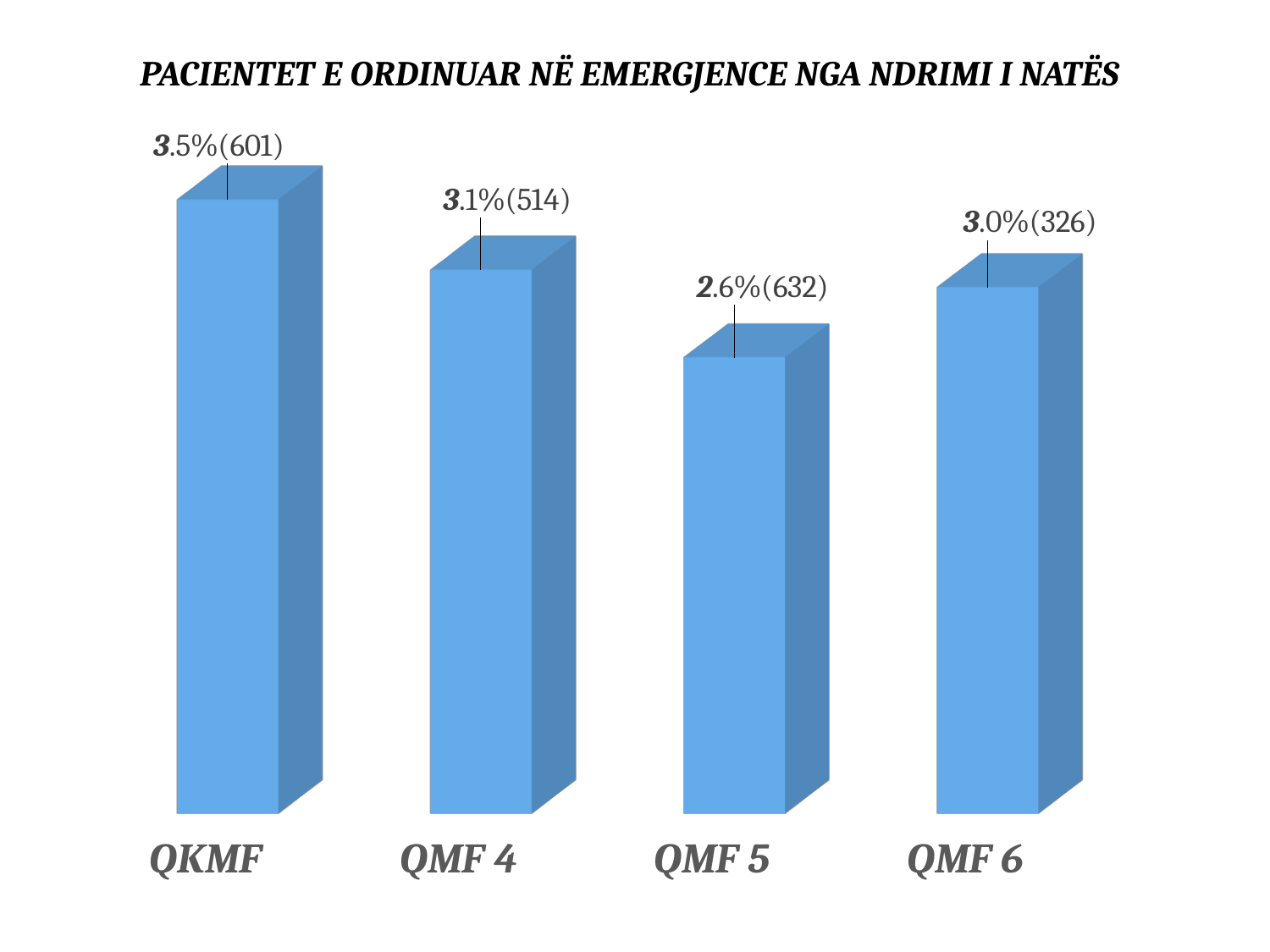
What kind of chart is shown on the slide? Bar chart What is the data label shown for QMF 4? 3.1%(514) What is the data label shown for QKMF? 3.5%(601) What colour are the bars in the chart? Blue Which has a higher percentage, QMF 4 or QMF 6? QMF 4 What is the data label shown for QMF 5? 2.6%(632) Which category has the highest percentage? QKMF How many categories are shown on the chart? 4 What is the title of the chart? PACIENTET E ORDINUAR NË EMERGJENCE NGA NDRIMI I NATËS What is the data label shown for QMF 6? 3.0%(326) Which category has the lowest percentage? QMF 5 What is the difference in percentage points between QKMF and QMF 5? 0.9